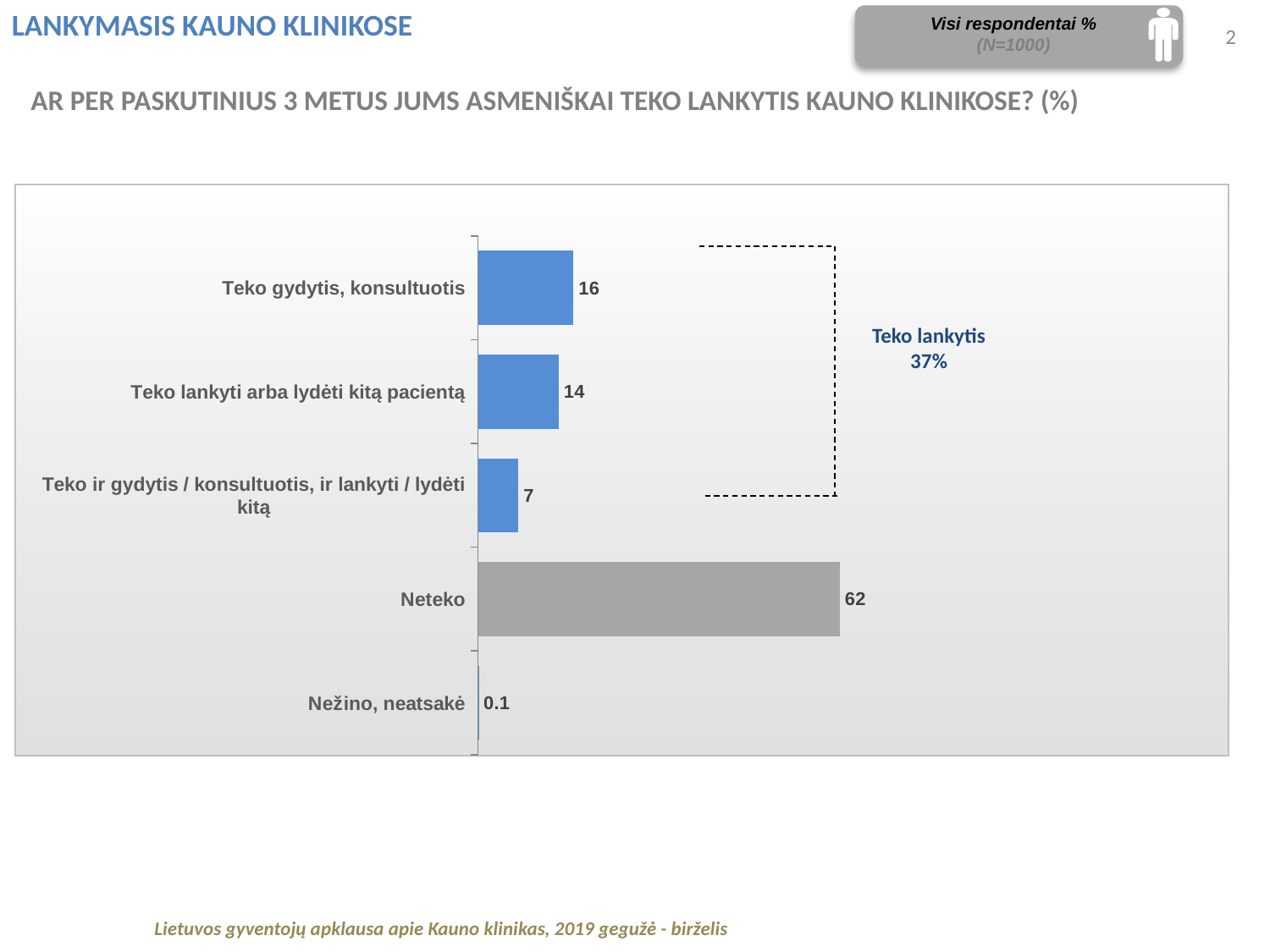
What kind of chart is shown on the slide? Bar chart What combined percentage is shown for "Teko lankytis" on the chart? 37% Which is larger: the value for "Teko gydytis, konsultuotis" or "Teko ir gydytis / konsultuotis, ir lankyti / lydėti kitą"? Teko gydytis, konsultuotis What is the value for "Nežino, neatsakė"? 0.1 What is the difference between the values for "Neteko" and "Teko gydytis, konsultuotis"? 46 What is the value for "Teko lankyti arba lydėti kitą pacientą"? 14 Which category has the lowest value? Nežino, neatsakė What is the value for "Neteko"? 62 What is the sample size (N) stated on the slide? N=1000 Which category has the highest value? Neteko What is the value for "Teko gydytis, konsultuotis"? 16 How many categories are shown in the chart? 5